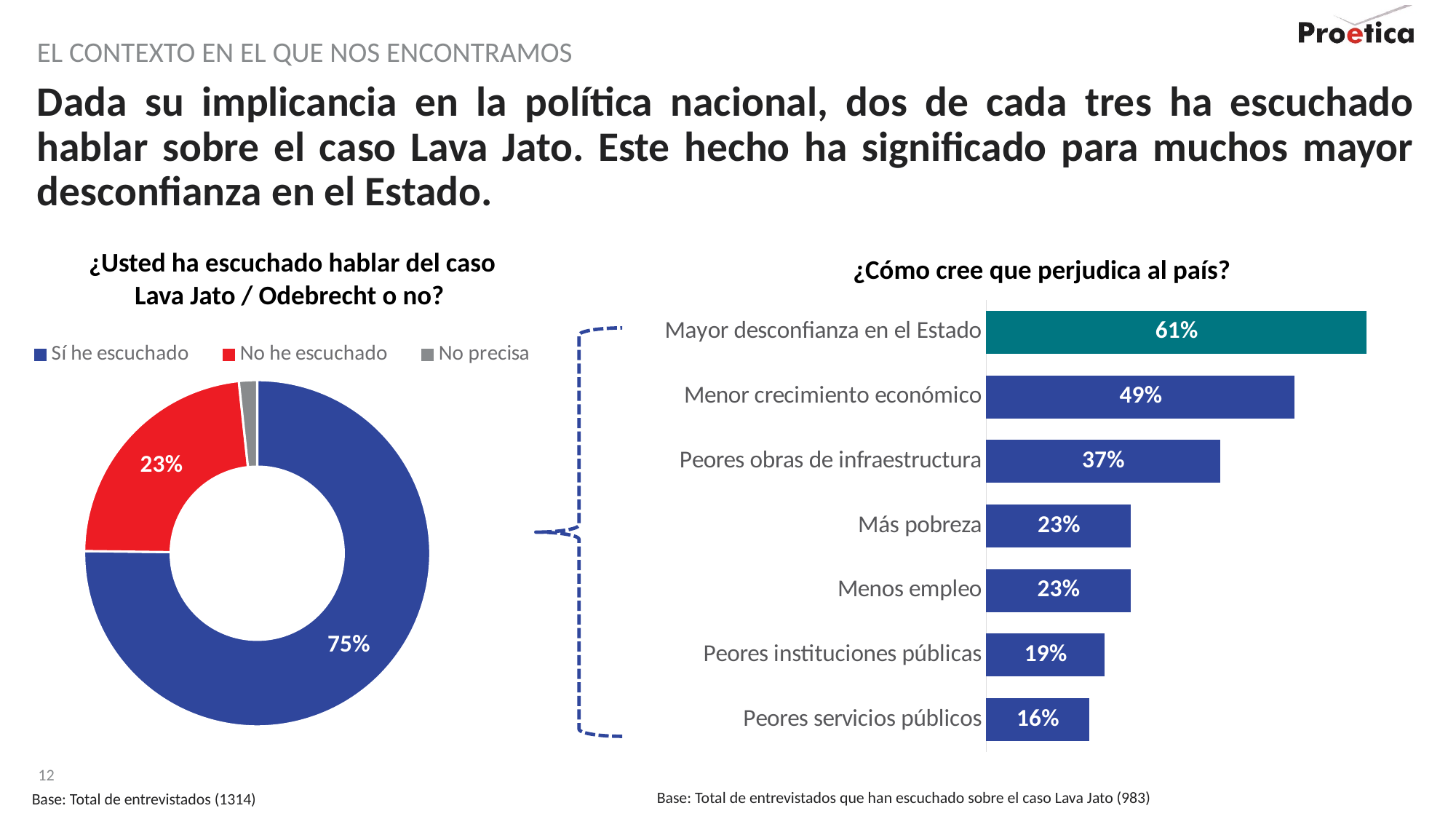
What kind of chart is the one titled '¿Cómo cree que perjudica al país?'? Bar chart In the chart titled '¿Cómo cree que perjudica al país?', what is the difference between 'Mayor desconfianza en el Estado' and 'Peores obras de infraestructura'? 24% In the chart titled '¿Cómo cree que perjudica al país?', what is the value for 'Peores instituciones públicas'? 19% In the chart titled '¿Usted ha escuchado hablar del caso Lava Jato / Odebrecht o no?', what share of respondents answered 'Sí he escuchado'? 75% In the chart titled '¿Cómo cree que perjudica al país?', which category has the highest value? Mayor desconfianza en el Estado In the chart titled '¿Usted ha escuchado hablar del caso Lava Jato / Odebrecht o no?', how many entries does the legend list? 3 In the chart titled '¿Cómo cree que perjudica al país?', what is the value for 'Menor crecimiento económico'? 49% In the chart titled '¿Cómo cree que perjudica al país?', how many categories are shown? 7 What kind of chart is the one titled '¿Usted ha escuchado hablar del caso Lava Jato / Odebrecht o no?'? Doughnut (pie) chart In the chart titled '¿Usted ha escuchado hablar del caso Lava Jato / Odebrecht o no?', what share of respondents answered 'No he escuchado'? 23% In the chart titled '¿Cómo cree que perjudica al país?', which category has the lowest value? Peores servicios públicos In the chart titled '¿Usted ha escuchado hablar del caso Lava Jato / Odebrecht o no?', which category has the smallest slice? No precisa